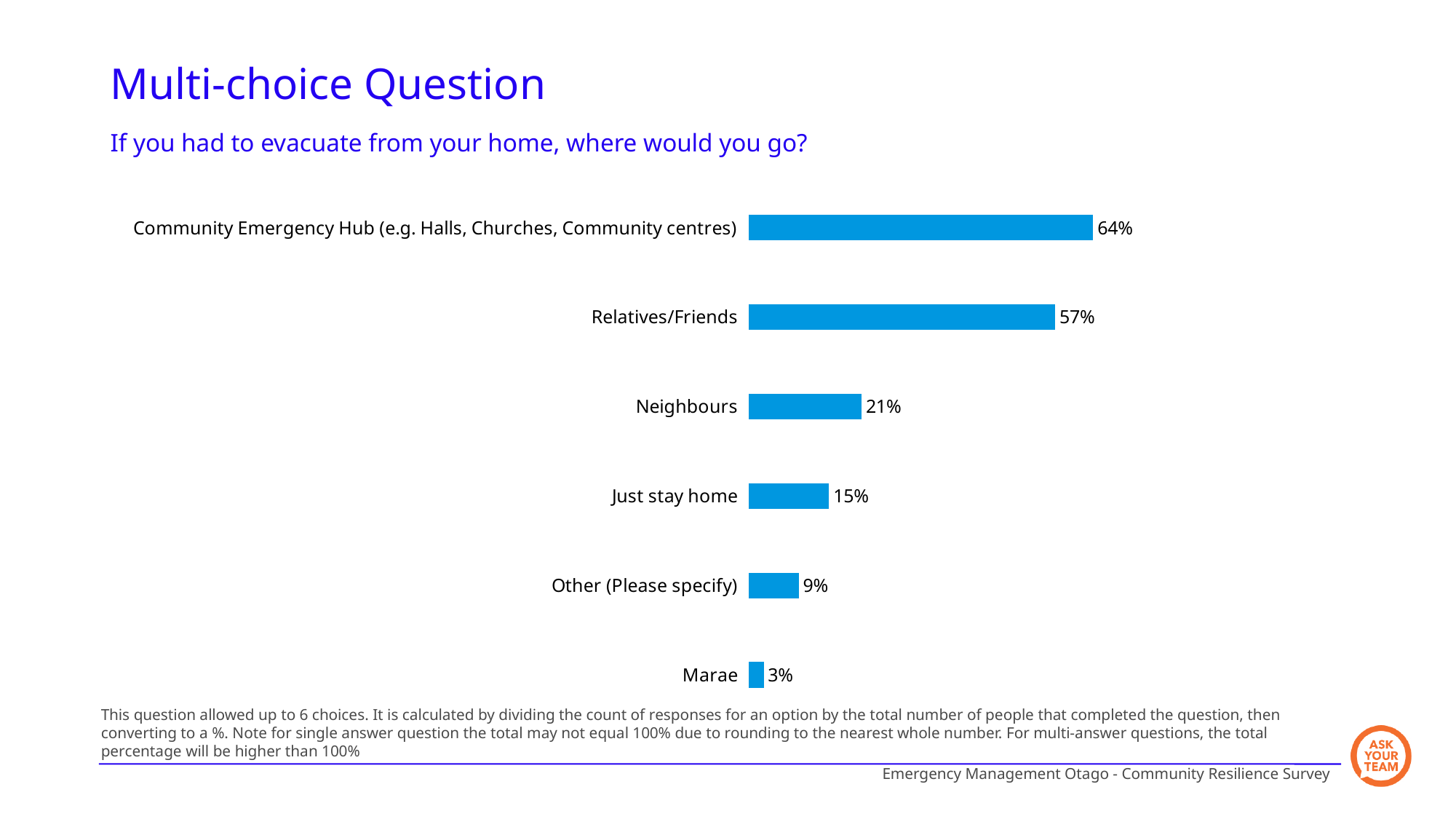
What percentage of respondents chose Neighbours? 21% How many options are shown in the chart? 6 What percentage of respondents said they would go to a Community Emergency Hub if they had to evacuate? 64% What is the value shown for Relatives/Friends? 57% Which is larger, the value for Neighbours or the value for Just stay home? Neighbours What type of chart is shown on the slide? Bar chart What is the difference in percentage points between Community Emergency Hub and Relatives/Friends? 7 What survey question does the chart answer? If you had to evacuate from your home, where would you go? Which option has the lowest percentage? Marae Which option has the highest percentage? Community Emergency Hub (e.g. Halls, Churches, Community centres) What percentage is shown for Marae? 3% What is the value for Just stay home? 15%